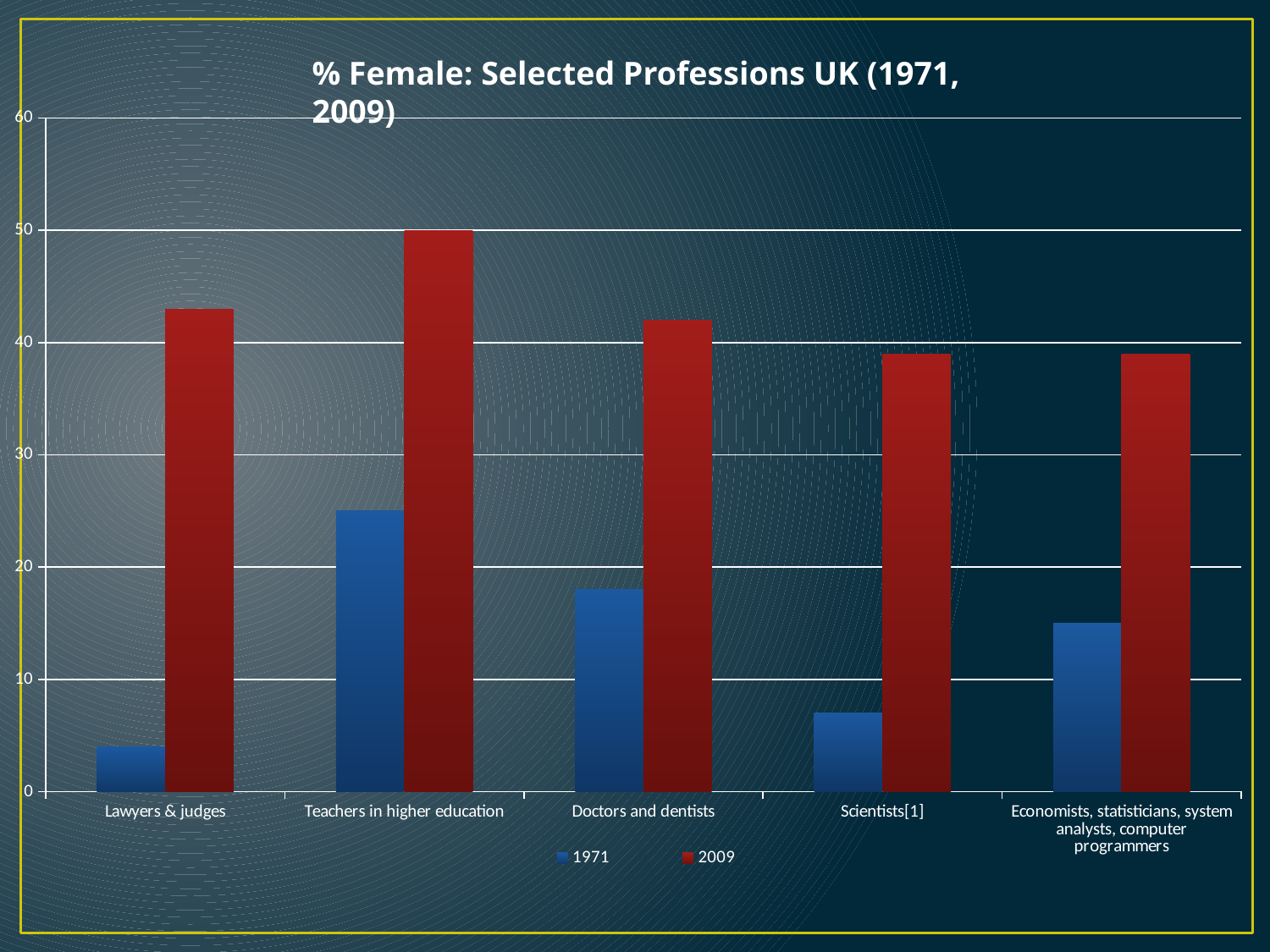
Is the 2009 value for Lawyers & judges greater or less than 40? greater Is the 1971 value for Scientists[1] greater or less than 10? less Which series is shown in red in the legend? 2009 What is the title of the chart? % Female: Selected Professions UK (1971, 2009) Which profession has the lowest 1971 value? Lawyers & judges Is the 1971 value for Doctors and dentists greater or less than 20? less Which profession has the highest 2009 value? Teachers in higher education How many profession categories are shown on the x axis? 5 How many series does the legend list? 2 Which profession has the highest 1971 value? Teachers in higher education What type of chart is shown on the slide? bar chart Which is larger: the 1971 value for Teachers in higher education or the 1971 value for Economists, statisticians, system analysts, computer programmers? Teachers in higher education